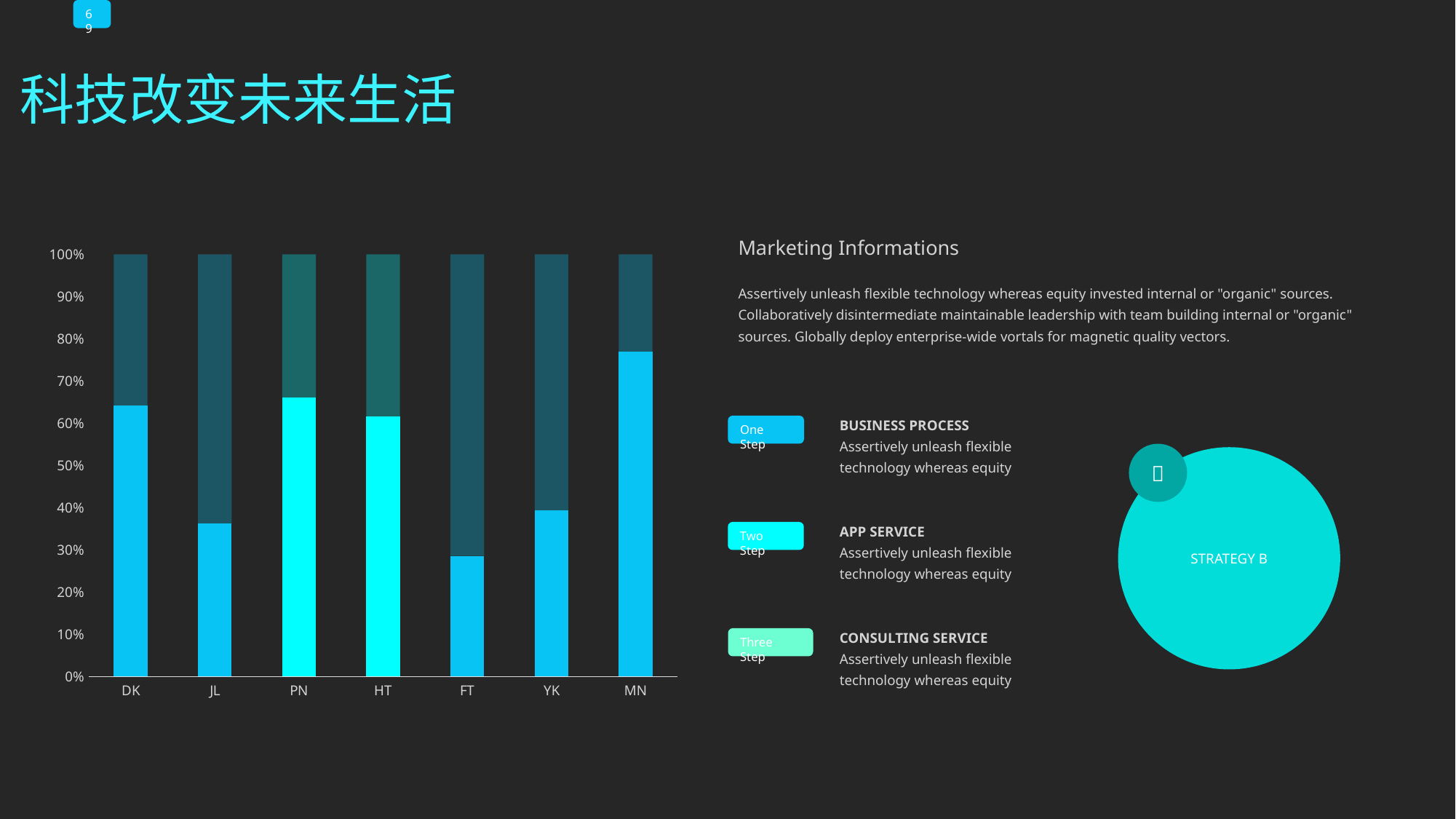
Which has the larger bottom segment, YK or HT? HT Which category has the tallest bottom (bright) segment in the bar chart? MN How many categories are shown on the x axis of the bar chart? 7 Which category has the shortest bottom (bright) segment in the bar chart? FT Is the bottom segment for DK greater or less than 50%? greater Is the bottom segment for JL greater or less than 40%? less Is the bottom segment for MN greater or less than 70%? greater What kind of chart is shown on the slide? stacked bar chart What is the highest value shown on the y axis of the bar chart? 100% Which has the larger bottom segment, DK or JL? DK